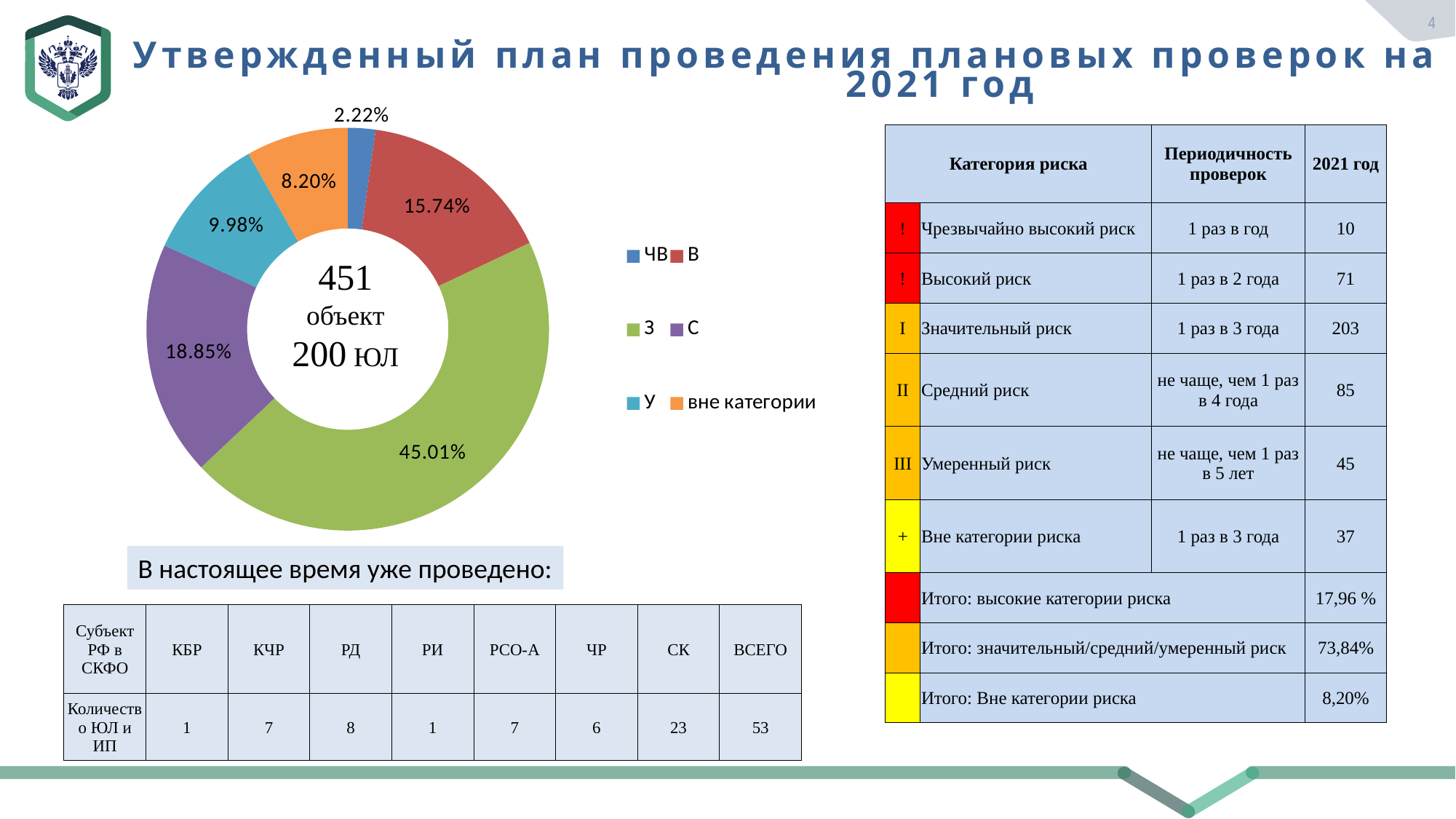
How many categories does the legend of the doughnut chart list? 6 What share of the doughnut chart does the "вне категории" slice represent? 8.20% What share of the doughnut chart does the "С" slice represent? 18.85% Which category has the largest slice in the doughnut chart? З What is the difference in percentage points between the "С" slice and the "В" slice? 3.11 Which slice is larger in the doughnut chart, "У" or "вне категории"? У What kind of chart is shown on the slide? Doughnut (pie) chart Which category has the smallest slice in the doughnut chart? ЧВ What share of the doughnut chart does the "З" slice represent? 45.01% What number of objects is written in the centre of the doughnut chart? 451 объект What colour is the "З" slice in the doughnut chart? Green What share of the doughnut chart does the "В" slice represent? 15.74%